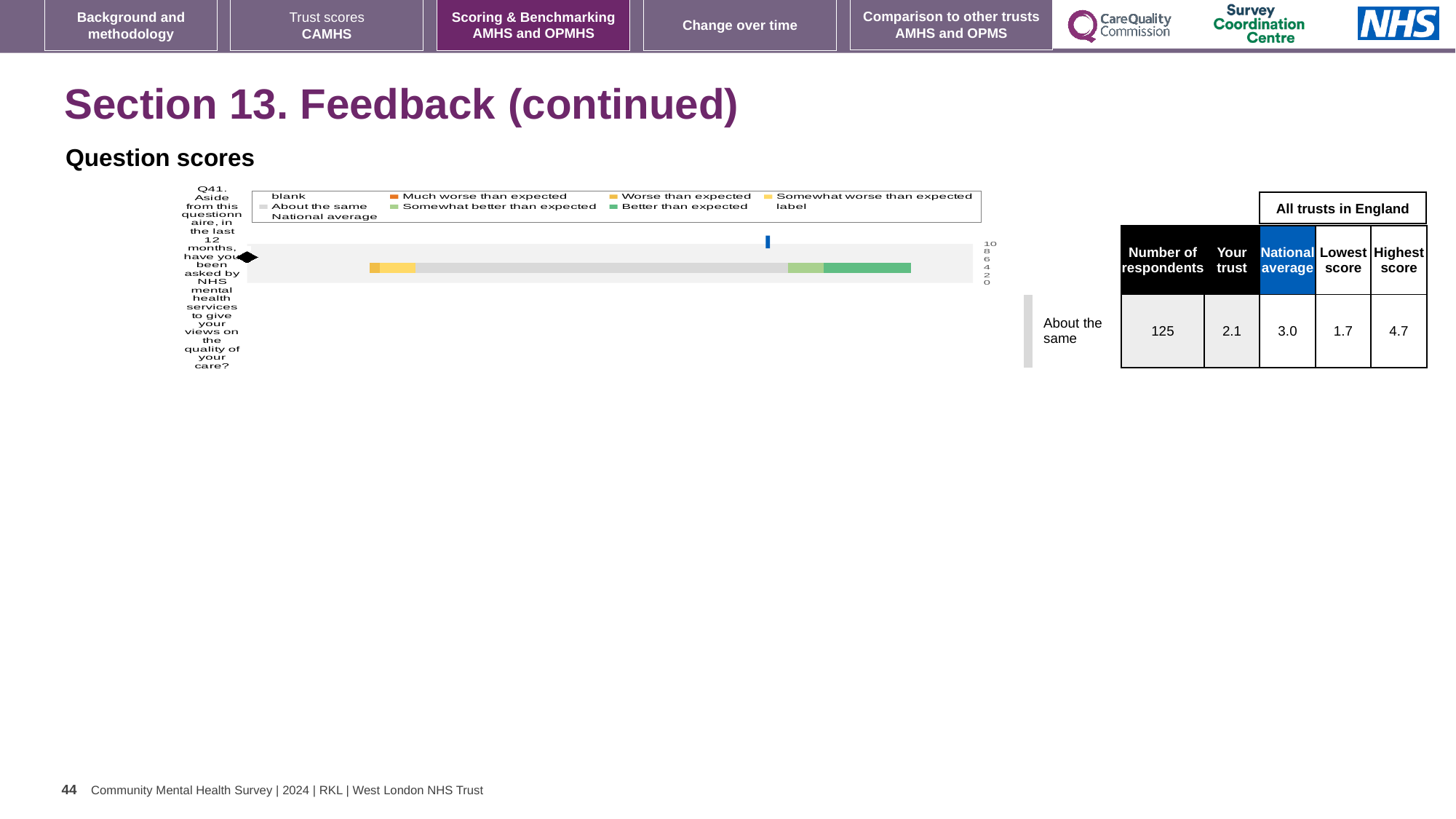
Which question number is plotted in the chart? Q41 In the table beside the chart, what is the national average score for Q41? 3.0 In the table beside the chart, what is the 'Your trust' score for Q41? 2.1 What colour represents 'Better than expected' in the chart legend? green What kind of chart is shown on the slide? bar chart How many questions are plotted as bars in the chart? 1 In the table beside the chart, how many respondents answered Q41? 125 How many entries does the chart's legend list? 9 In the table beside the chart, what is the difference between the highest score and the lowest score for Q41? 3.0 What benchmark category is shown for Q41 next to the chart? About the same In the table beside the chart, which is larger for Q41: the 'Your trust' score or the national average? National average In the table beside the chart, what is the highest score among all trusts in England for Q41? 4.7